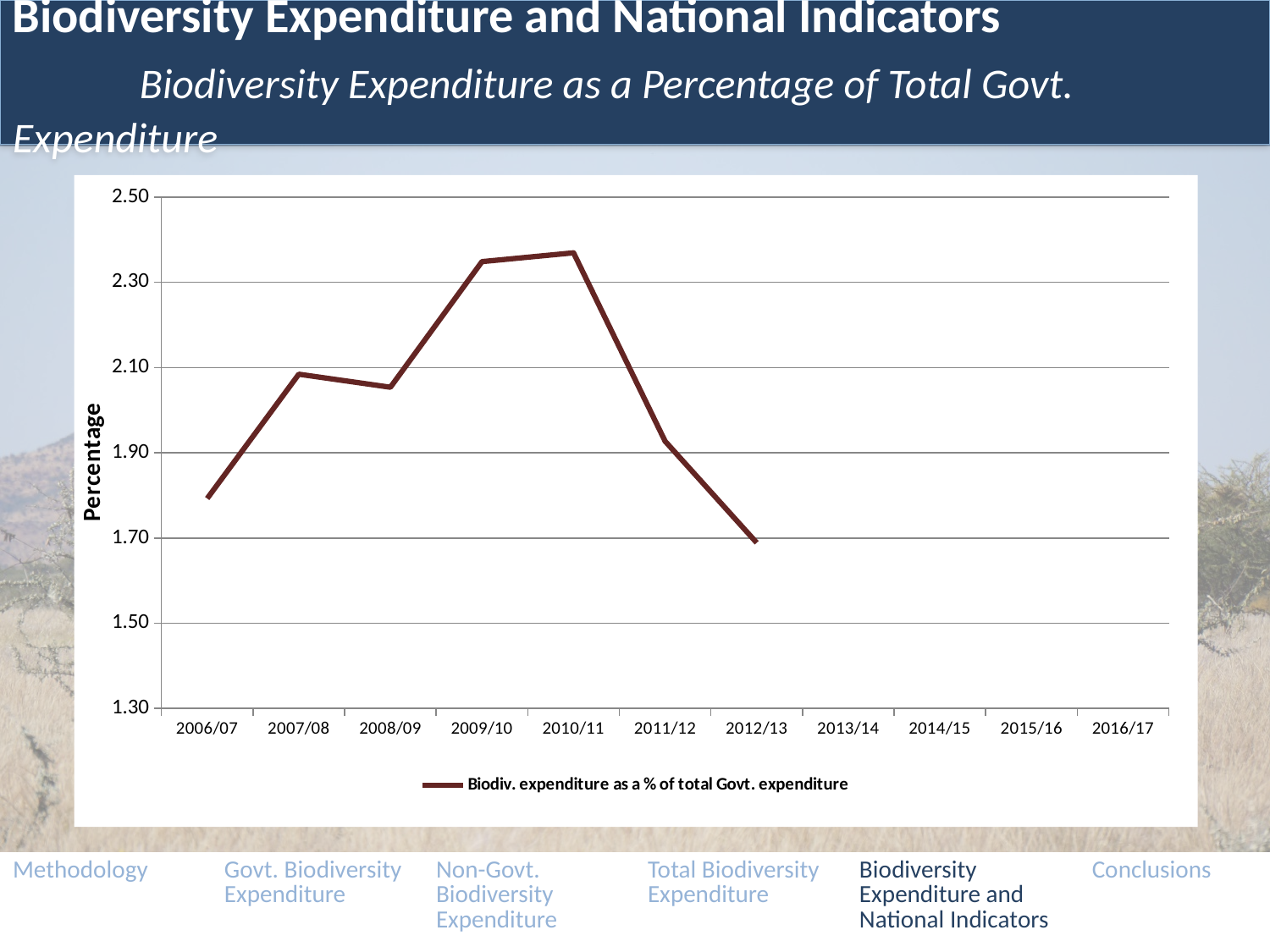
How many year labels are shown on the x axis? 11 How many series does the legend list? 1 Is the value for 2006/07 greater or less than 1.90? less What is the label on the vertical axis? Percentage Is the value for 2009/10 greater or less than 2.30? greater Which is larger, the value for 2009/10 or the value for 2011/12? 2009/10 Is the value for 2011/12 greater or less than 2.10? less Which year has the lowest plotted value? 2012/13 How many years have a plotted value on the line? 7 What kind of chart is shown on the slide? line chart Do the values rise or fall from 2010/11 to 2012/13? fall What is the legend entry for the plotted line? Biodiv. expenditure as a % of total Govt. expenditure